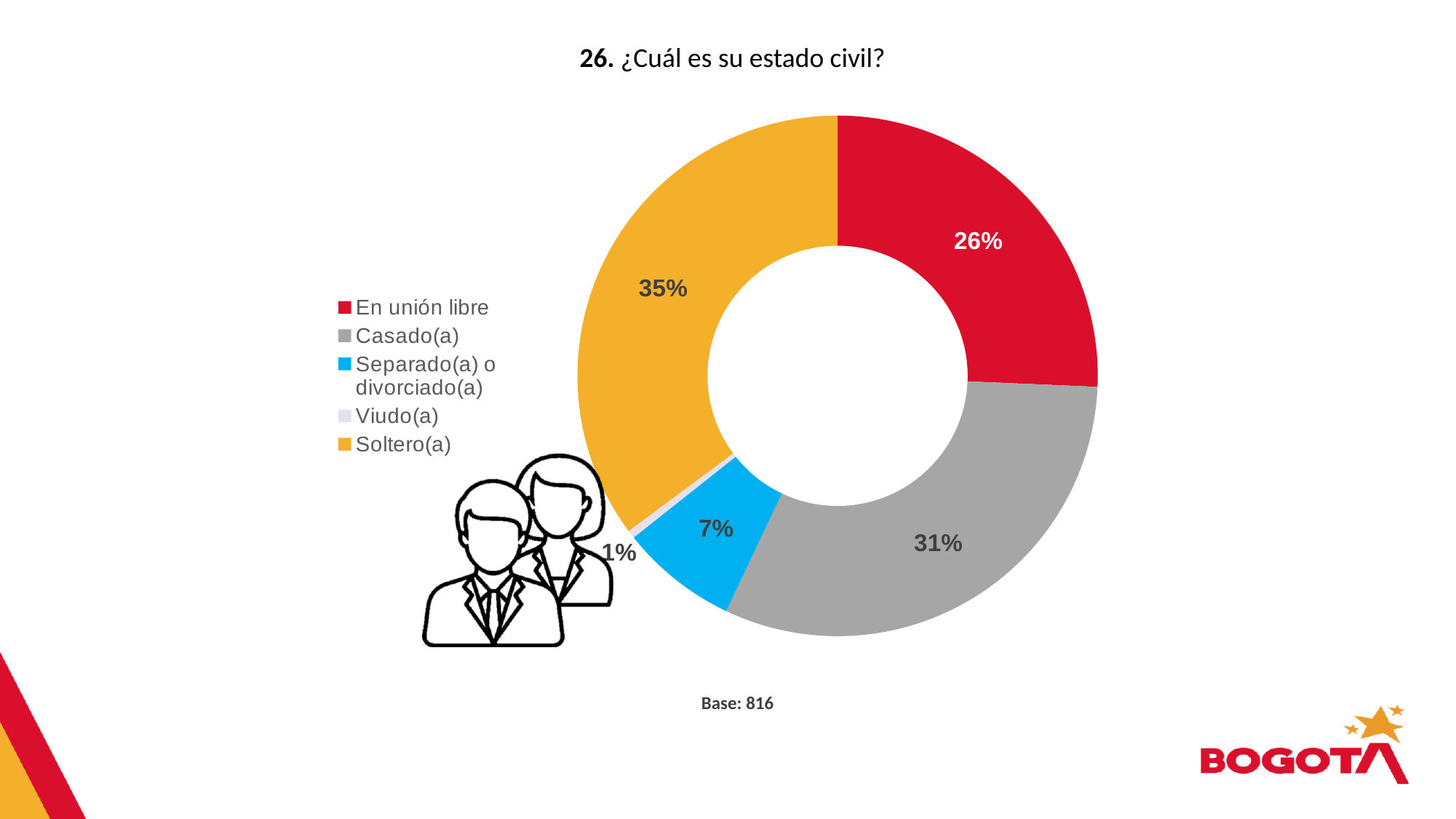
What percentage of respondents are 'Soltero(a)'? 35% What is the difference in percentage points between 'Soltero(a)' and 'En unión libre'? 9 What percentage of respondents are 'Separado(a) o divorciado(a)'? 7% Which marital status has the largest share of the pie? Soltero(a) Which marital status has the smallest share of the pie? Viudo(a) Which is larger, the share for 'Casado(a)' or the share for 'En unión libre'? Casado(a) What percentage of respondents are 'Viudo(a)'? 1% What is the base (number of respondents) shown below the chart? 816 What kind of chart is shown on the slide? Pie chart (doughnut) How many categories does the legend list? 5 What percentage of respondents are 'En unión libre'? 26% What percentage of respondents are 'Casado(a)'? 31%